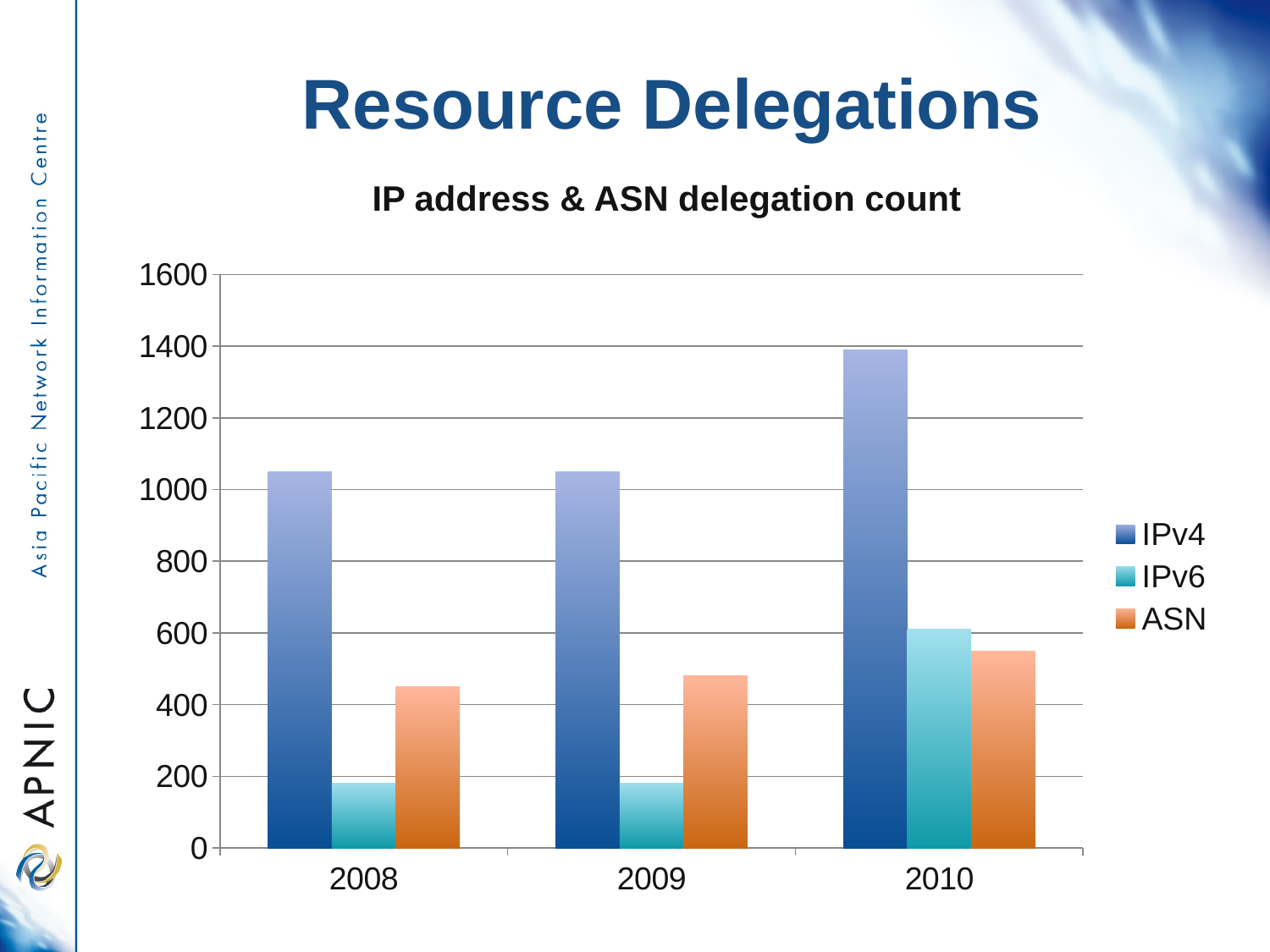
Is the IPv6 value for 2008 greater or less than 200? less What kind of chart is shown on the slide? bar chart How many series does the legend list? 3 Is the ASN value for 2010 greater or less than 600? less Which series has the lowest value in 2008? IPv6 Is the IPv4 value for 2010 greater or less than 1200? greater How many years are shown on the x axis? 3 Which year has the highest IPv4 value? 2010 What is the title of the chart? IP address & ASN delegation count Does the IPv4 value rise or fall from 2009 to 2010? rise In 2009, which is larger, the ASN value or the IPv6 value? ASN